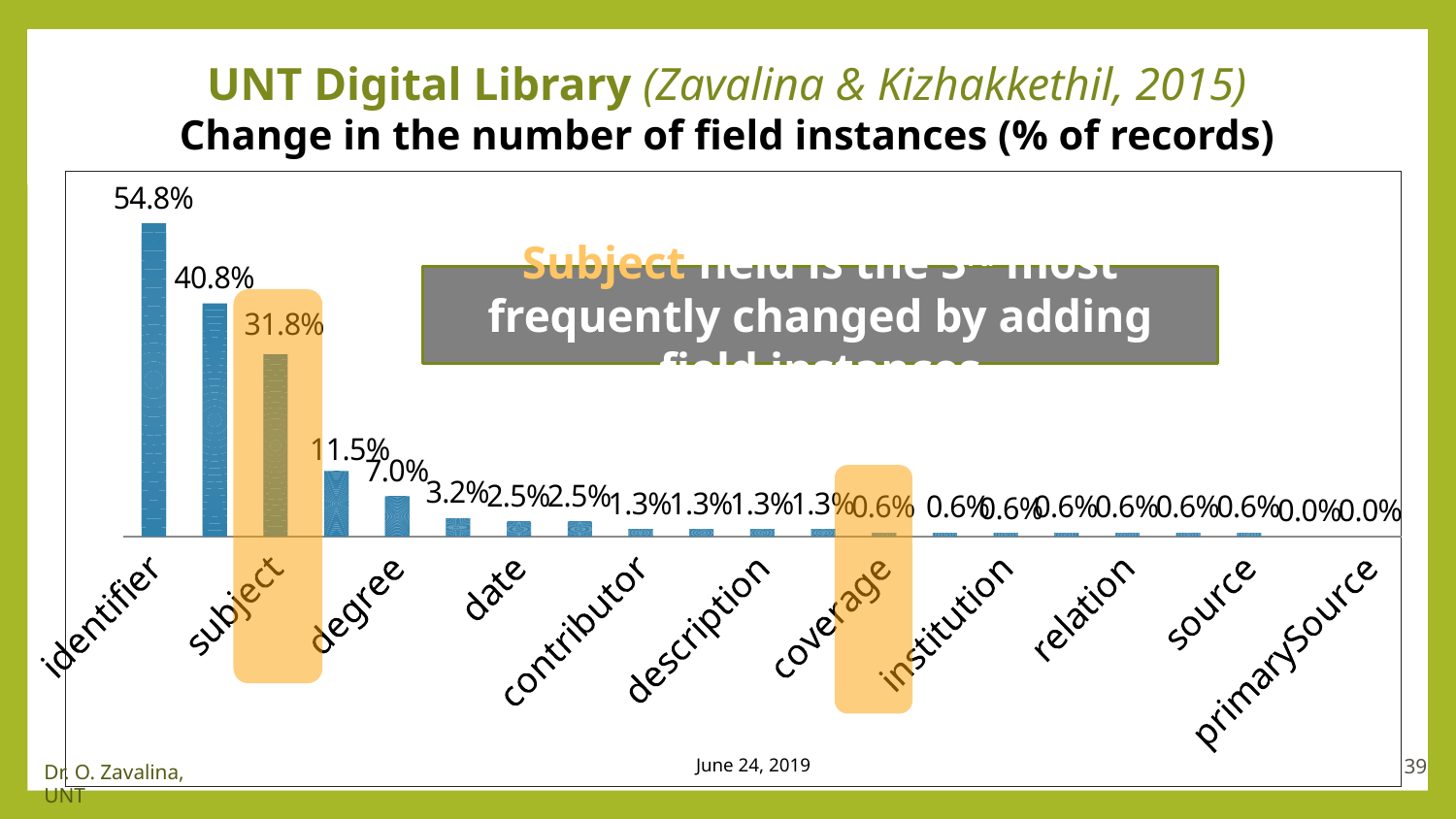
What is the value for coverage? 0.6% Which two categories are highlighted with orange shading on the chart? subject and coverage What is the value for identifier? 54.8% Which is larger, the value for subject or the value for degree? subject What is the difference between the values for identifier and subject? 23.0% What is the value for primarySource? 0.0% Which category has the highest value? identifier What is the value for degree? 7.0% What kind of chart is shown on the slide? bar chart What is the value for subject? 31.8% What is the subtitle of the chart below 'UNT Digital Library'? Change in the number of field instances (% of records) Do the values rise or fall from left to right along the x axis? fall